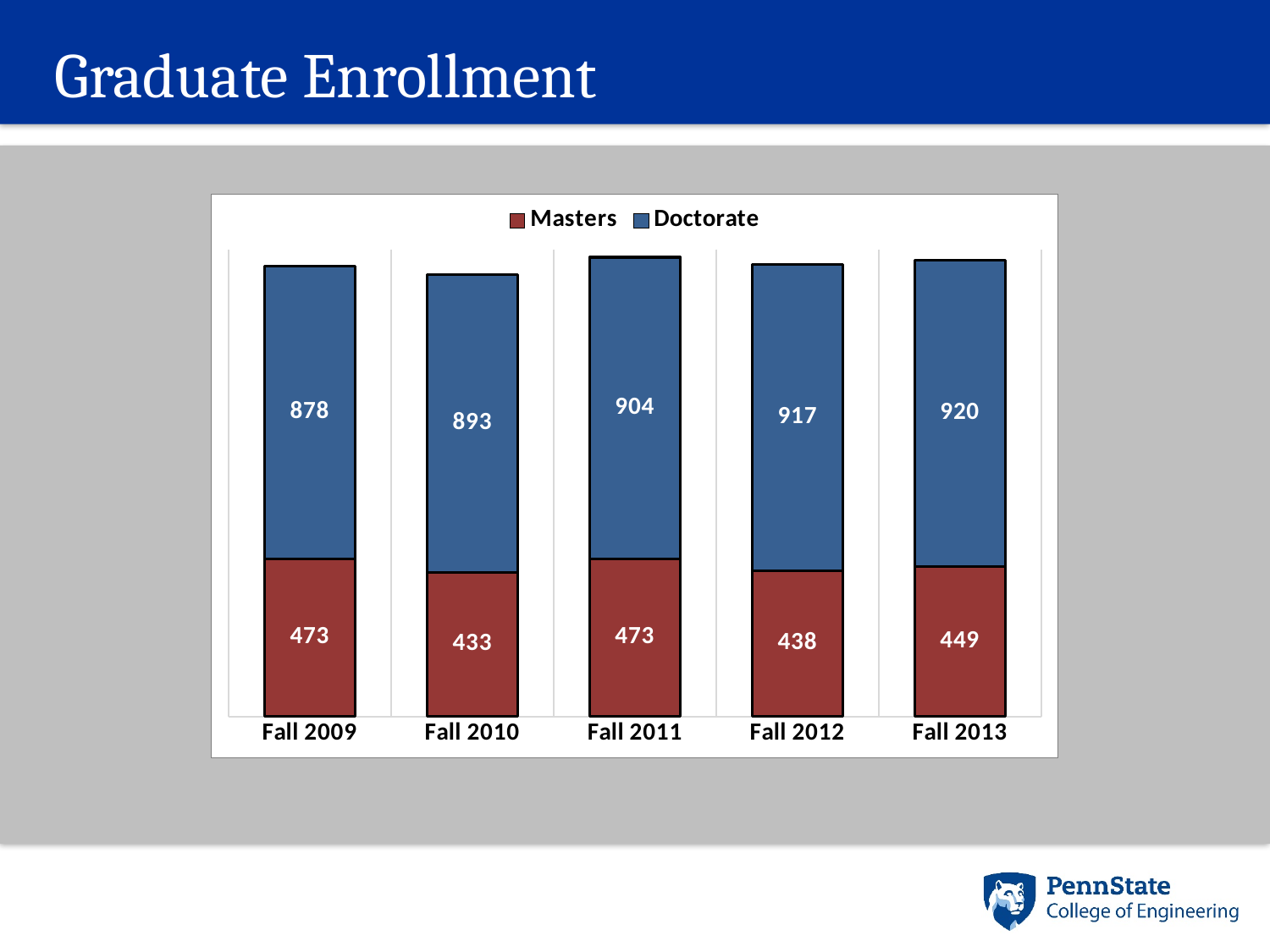
Which term has the lowest Doctorate enrollment? Fall 2009 What is the Masters enrollment for Fall 2010? 433 Is the Masters enrollment larger in Fall 2011 or Fall 2012? Fall 2011 What is the total graduate enrollment (Masters plus Doctorate) for Fall 2011? 1377 Which term has the lowest Masters enrollment? Fall 2010 What is the Doctorate enrollment for Fall 2012? 917 How many series does the legend list? 2 What is the Masters enrollment for Fall 2013? 449 What is the difference between the Doctorate enrollment in Fall 2013 and Fall 2009? 42 Does the Doctorate enrollment rise or fall from Fall 2009 to Fall 2013? rise Which term has the highest Doctorate enrollment? Fall 2013 How many terms are shown on the x axis? 5